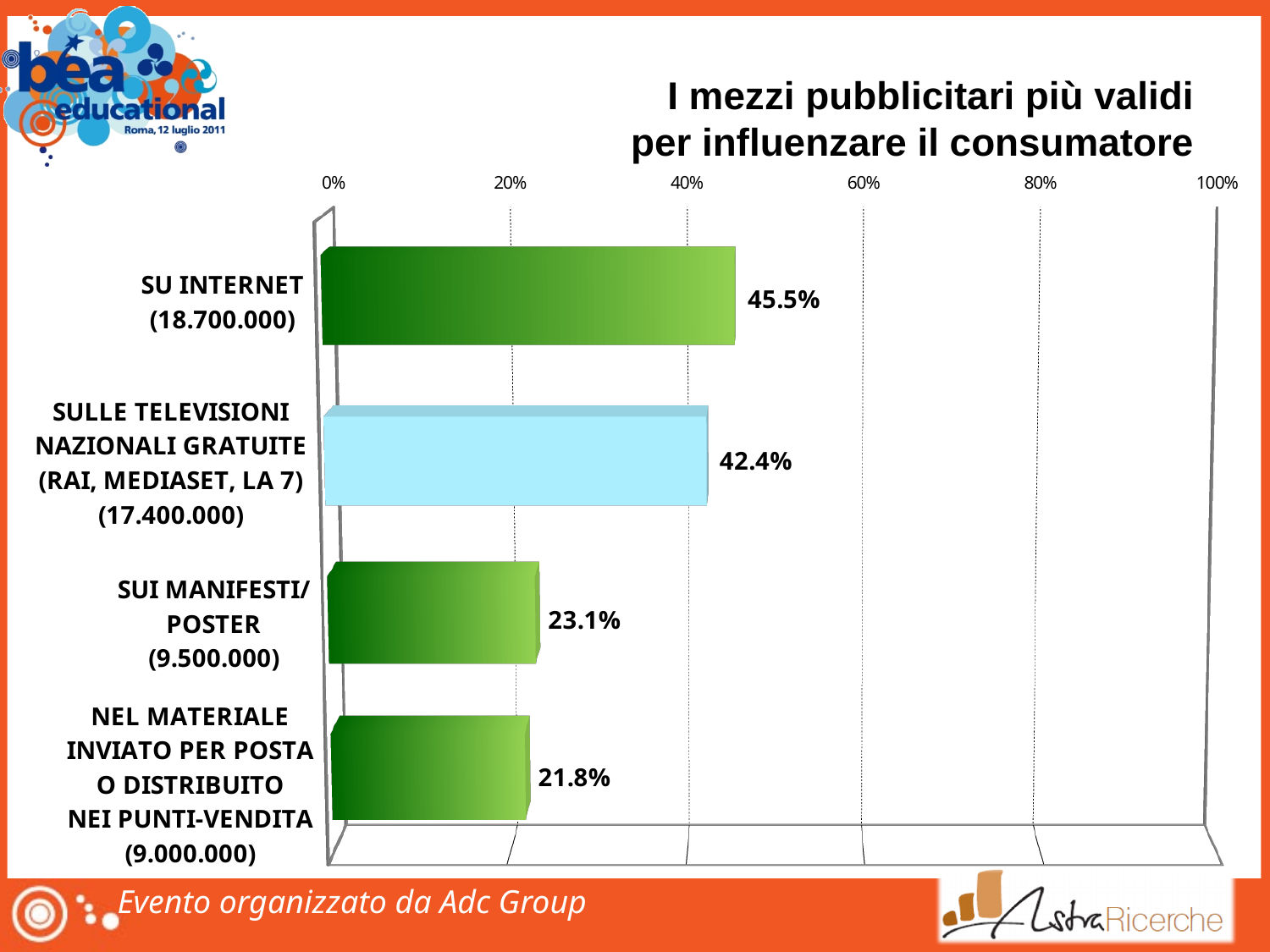
Which category has the highest value? SU INTERNET What is the value for SUI MANIFESTI/POSTER? 23.1% Is the value for SUI MANIFESTI/POSTER greater or less than 40%? less What is the value for NEL MATERIALE INVIATO PER POSTA O DISTRIBUITO NEI PUNTI-VENDITA? 21.8% Which category has the lowest value? NEL MATERIALE INVIATO PER POSTA O DISTRIBUITO NEI PUNTI-VENDITA What is the value for SULLE TELEVISIONI NAZIONALI GRATUITE (RAI, MEDIASET, LA 7)? 42.4% What is the difference between the values for SU INTERNET and SUI MANIFESTI/POSTER? 22.4% What kind of chart is shown on the slide? bar chart What is the title of the chart? I mezzi pubblicitari più validi per influenzare il consumatore Which is larger, the value for SU INTERNET or the value for SULLE TELEVISIONI NAZIONALI GRATUITE? SU INTERNET What is the value for SU INTERNET? 45.5% How many categories are shown in the chart? 4